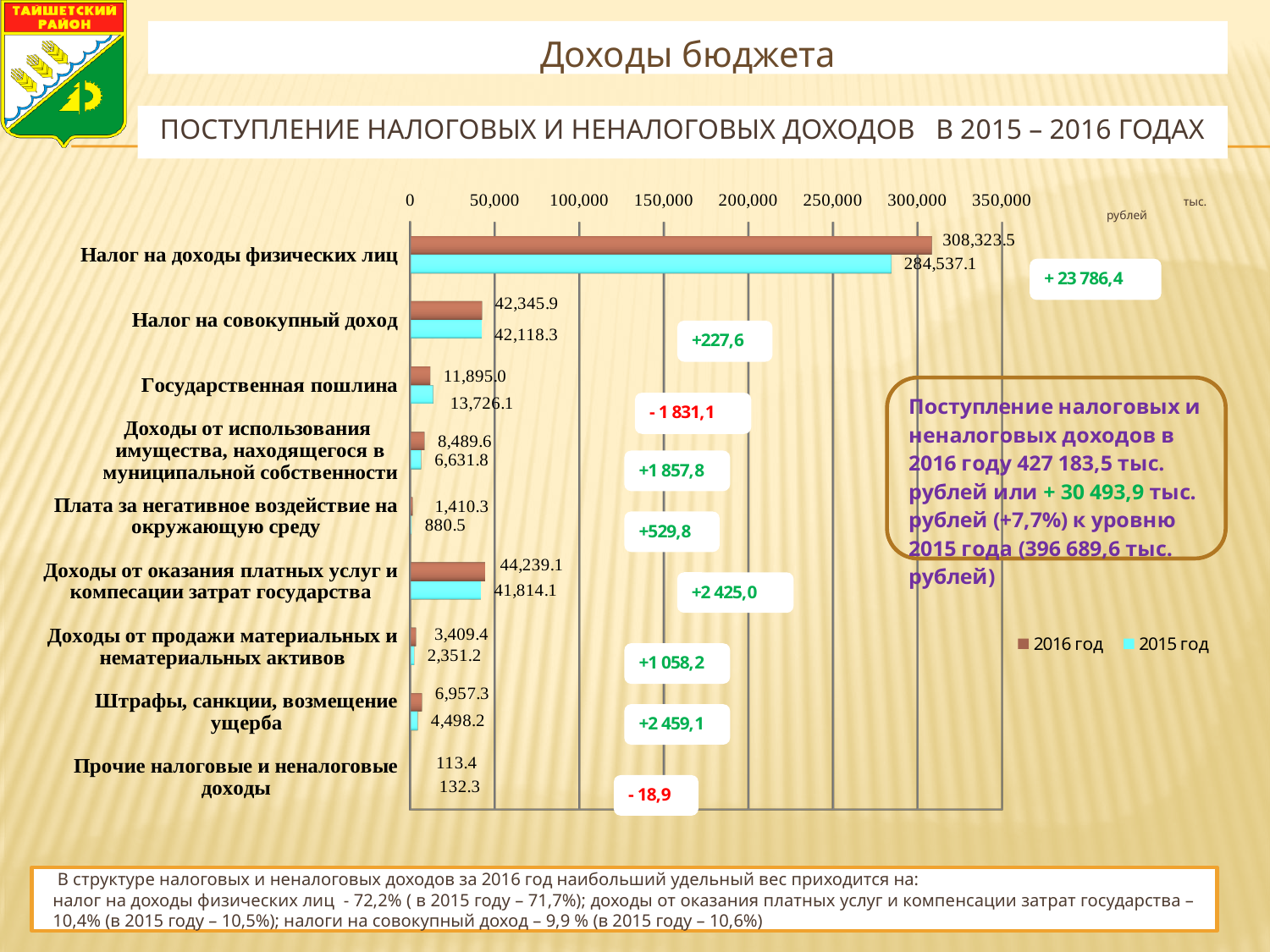
What is the 2016 год value for Штрафы, санкции, возмещение ущерба? 6,957.3 What is the difference between the 2016 год and 2015 год values for Налог на доходы физических лиц? 23,786.4 Which series is shown in brown in the legend? 2016 год How many categories are plotted on the chart? 9 What type of chart is shown on the slide? bar chart For Государственная пошлина, which is larger: the 2016 год value or the 2015 год value? 2015 год How many series does the chart legend list? 2 Which category has the highest 2016 год value? Налог на доходы физических лиц What is the 2015 год value for Налог на доходы физических лиц? 284,537.1 What is the 2015 год value for Государственная пошлина? 13,726.1 What is the 2016 год value for Налог на доходы физических лиц? 308,323.5 Which category has the lowest 2015 год value? Прочие налоговые и неналоговые доходы